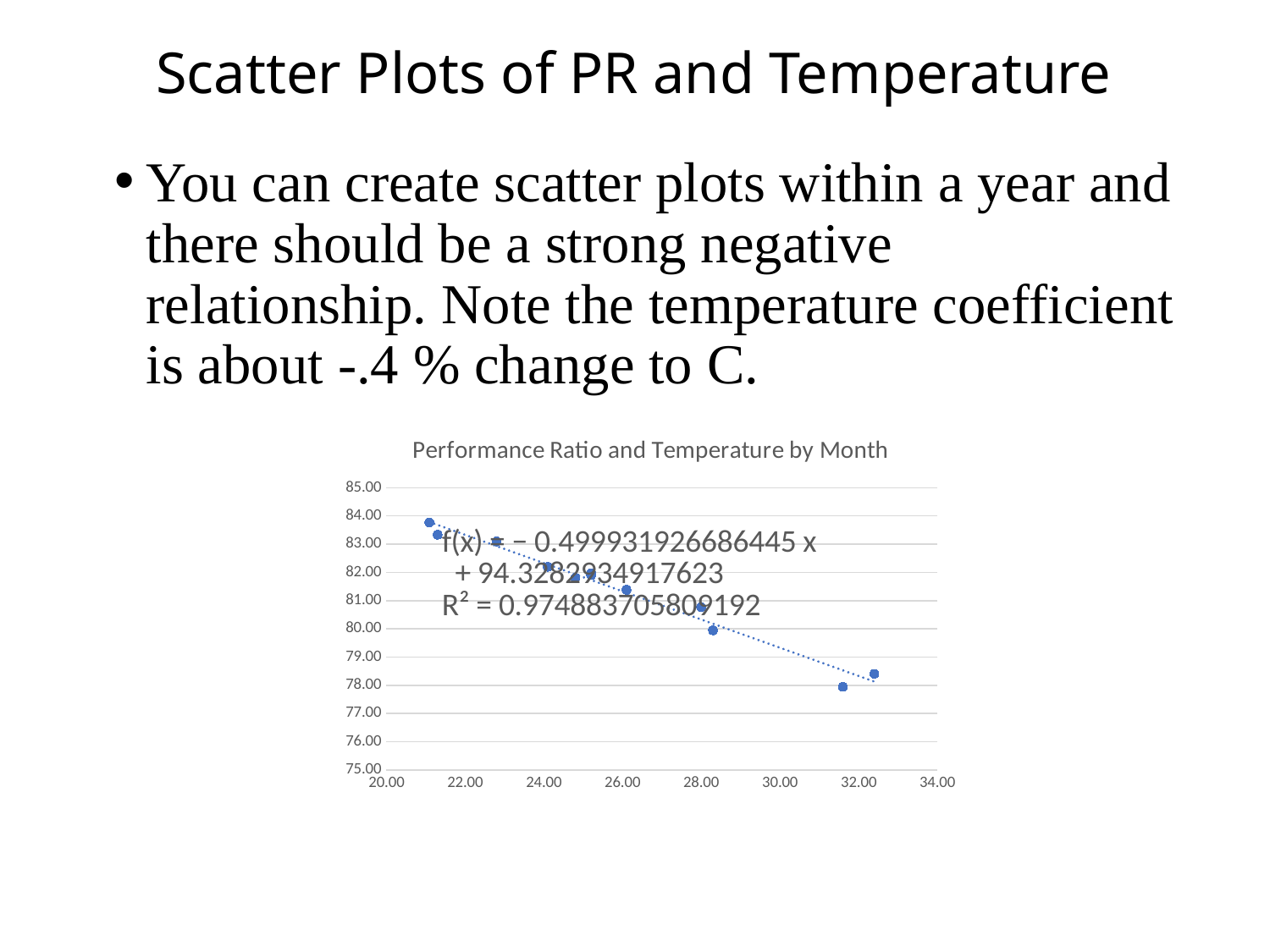
What is the highest value shown on the y-axis? 85.00 Is the value of the rightmost point (near x = 32) greater or less than 79.00? less What is the slope coefficient of x in the trendline equation shown on the chart? −0.499931926686445 What kind of chart is shown on the slide? scatter plot What is the title of the chart? Performance Ratio and Temperature by Month Which point has the lowest y value: the one near x = 21 or the one near x = 31.5? the one near x = 31.5 Is the value of the point near x = 31.5 greater or less than 79.00? less Is the value of the leftmost point (near x = 21) greater or less than 83.00? greater What is the intercept in the trendline equation shown on the chart? 94.3282934917623 What R² value is printed on the chart? R² = 0.974883705809192 Do the plotted values rise or fall as the x-axis value increases? fall